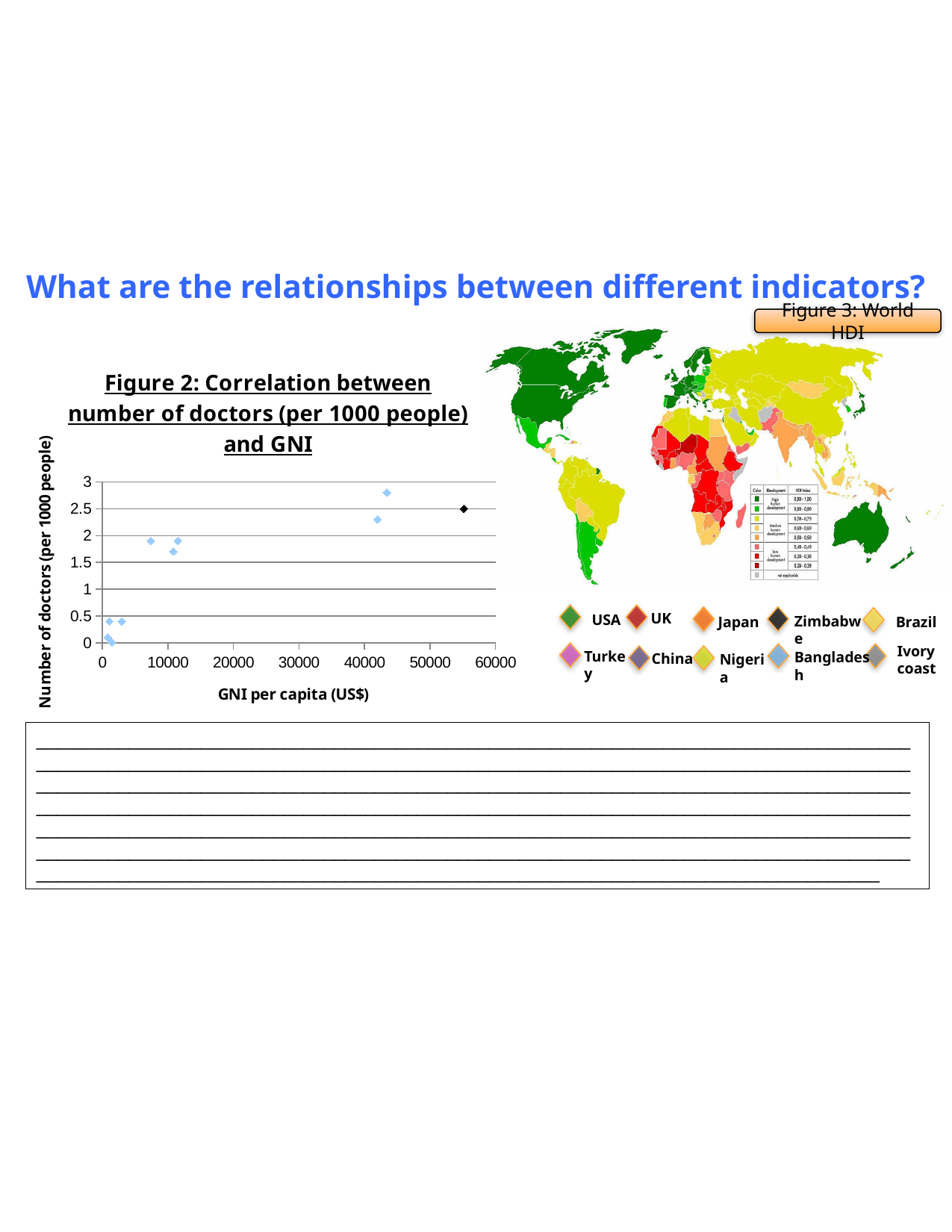
In Figure 2, what is the label of the x axis? GNI per capita (US$) In Figure 2, what is the highest value shown on the y axis? 3 In Figure 2, does the point with the highest GNI per capita also have the highest number of doctors? No In Figure 2, is the number of doctors for the point with the highest GNI per capita greater or less than 2? greater What kind of chart is Figure 2? Scatter chart In Figure 2, do the number of doctors generally rise or fall as GNI per capita increases? Rise In Figure 2, how many tick labels are shown on the x axis? 7 In Figure 2, is the number of doctors for the points with GNI per capita below 5000 greater or less than 0.5? less How many countries are listed in the legend below the map? 10 In Figure 2, is the GNI per capita of the point with the most doctors greater or less than 40000? greater What is the title of the chart on the left of the slide? Figure 2: Correlation between number of doctors (per 1000 people) and GNI